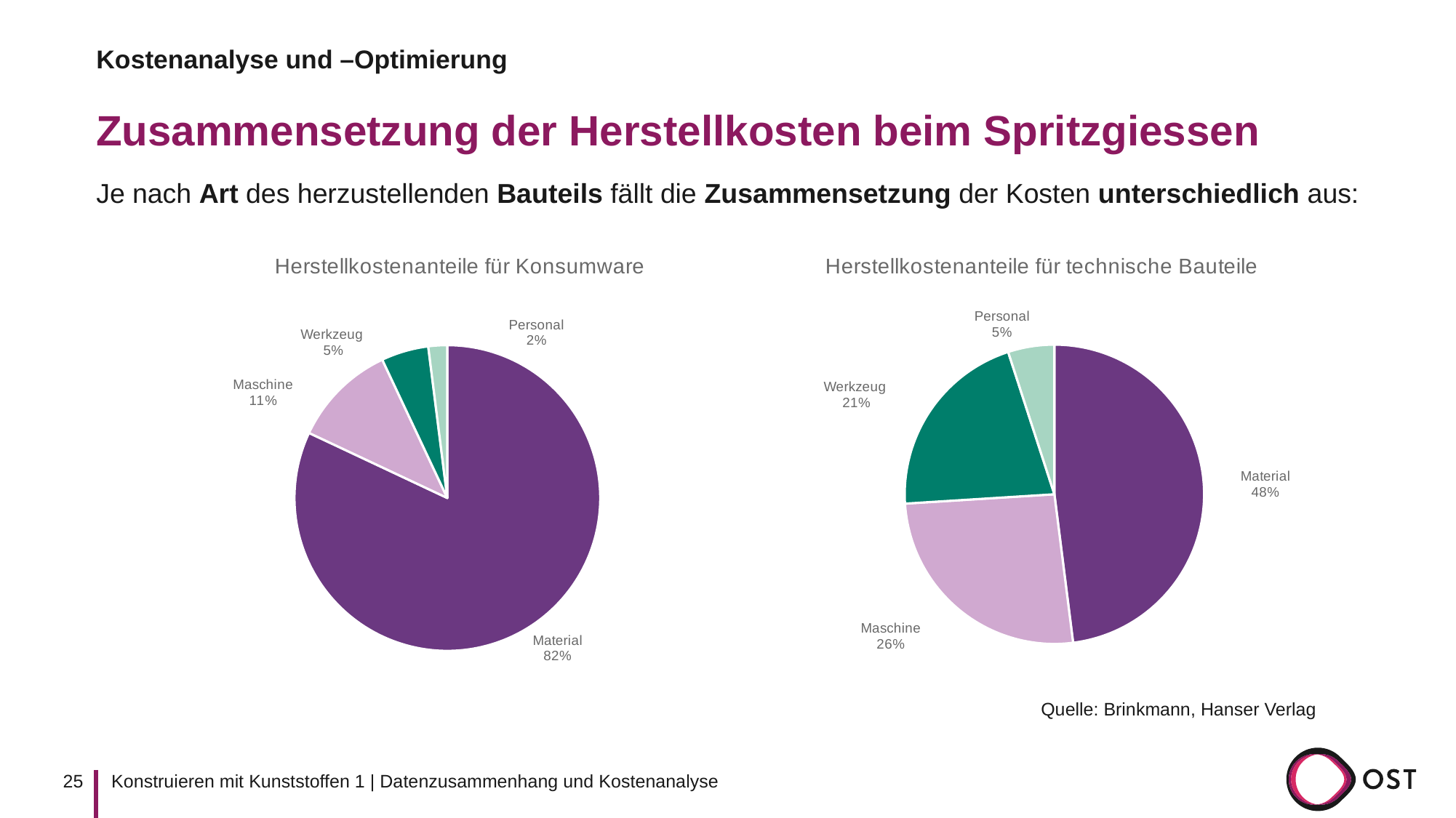
What is the title of the chart on the left side of the slide? Herstellkostenanteile für Konsumware In the chart 'Herstellkostenanteile für Konsumware', what share does Material have? 82% How many categories does the chart 'Herstellkostenanteile für Konsumware' show? 4 In the chart 'Herstellkostenanteile für technische Bauteile', what is the difference between the Material and Maschine shares? 22% In the chart 'Herstellkostenanteile für technische Bauteile', which category has the largest slice? Material In the chart 'Herstellkostenanteile für technische Bauteile', which is larger, Werkzeug or Maschine? Maschine In the chart 'Herstellkostenanteile für Konsumware', what is the difference between the Maschine and Werkzeug shares? 6% In the chart 'Herstellkostenanteile für Konsumware', what is the value for Werkzeug? 5% In the chart 'Herstellkostenanteile für technische Bauteile', what share does Maschine have? 26% In the chart 'Herstellkostenanteile für Konsumware', which category has the smallest slice? Personal What kind of chart is 'Herstellkostenanteile für technische Bauteile'? Pie chart In the chart 'Herstellkostenanteile für technische Bauteile', what is the value for Personal? 5%